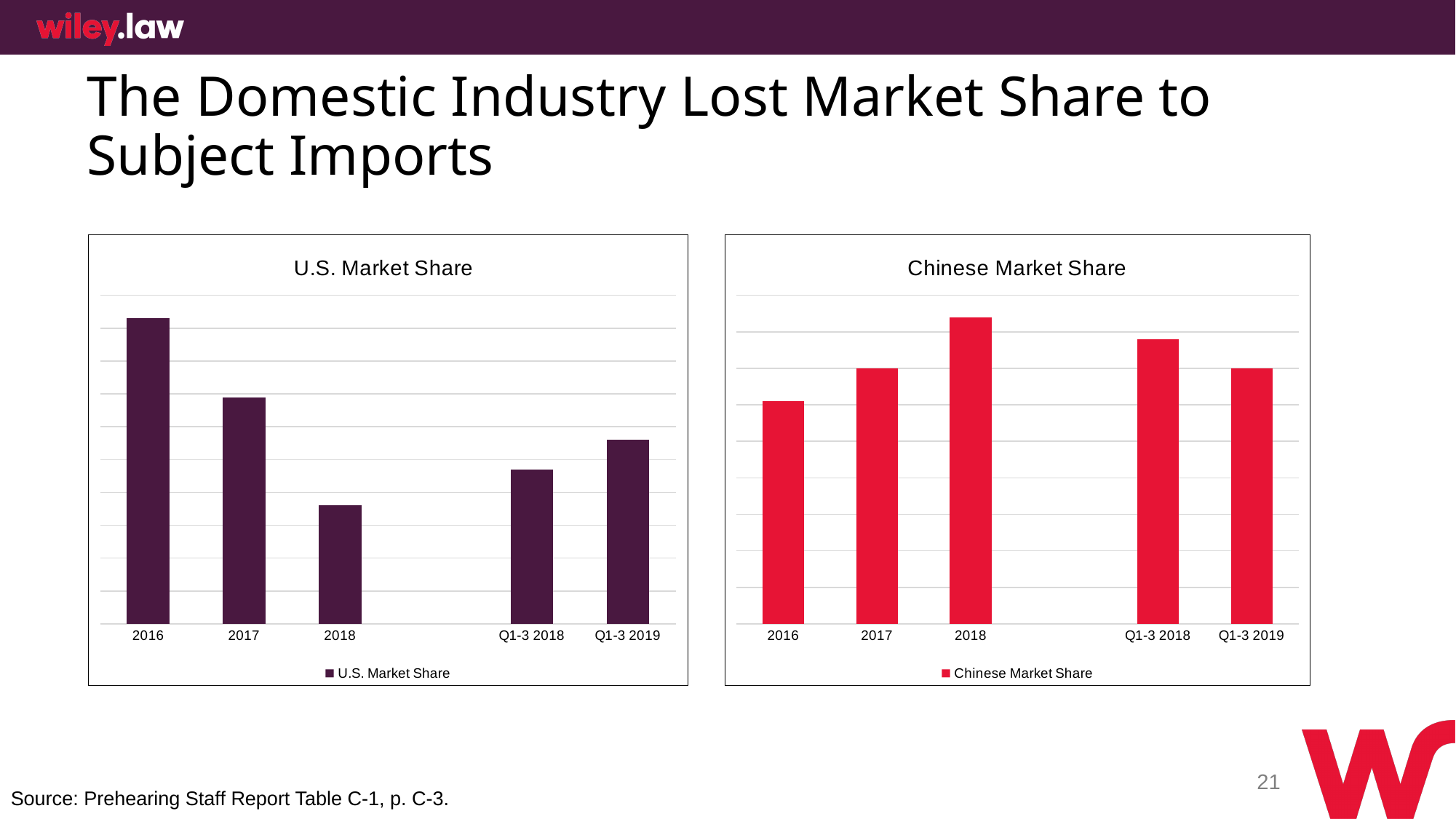
How many periods are shown on the x axis of the U.S. Market Share chart? 5 In the U.S. Market Share chart, which period has the lowest value? 2018 In the U.S. Market Share chart, which period has the highest value? 2016 How many series does the legend of the Chinese Market Share chart list? 1 In the U.S. Market Share chart, which is larger, the value for 2017 or the value for 2018? 2017 In the Chinese Market Share chart, which is larger, the value for Q1-3 2018 or the value for Q1-3 2019? Q1-3 2018 In the Chinese Market Share chart, do the values rise or fall from 2016 to 2018? rise In the Chinese Market Share chart, which period has the lowest value? 2016 In the U.S. Market Share chart, which is larger, the value for Q1-3 2018 or the value for Q1-3 2019? Q1-3 2019 In the Chinese Market Share chart, which period has the highest value? 2018 What kind of chart is the U.S. Market Share chart? bar chart In the U.S. Market Share chart, do the values rise or fall from 2016 to 2018? fall